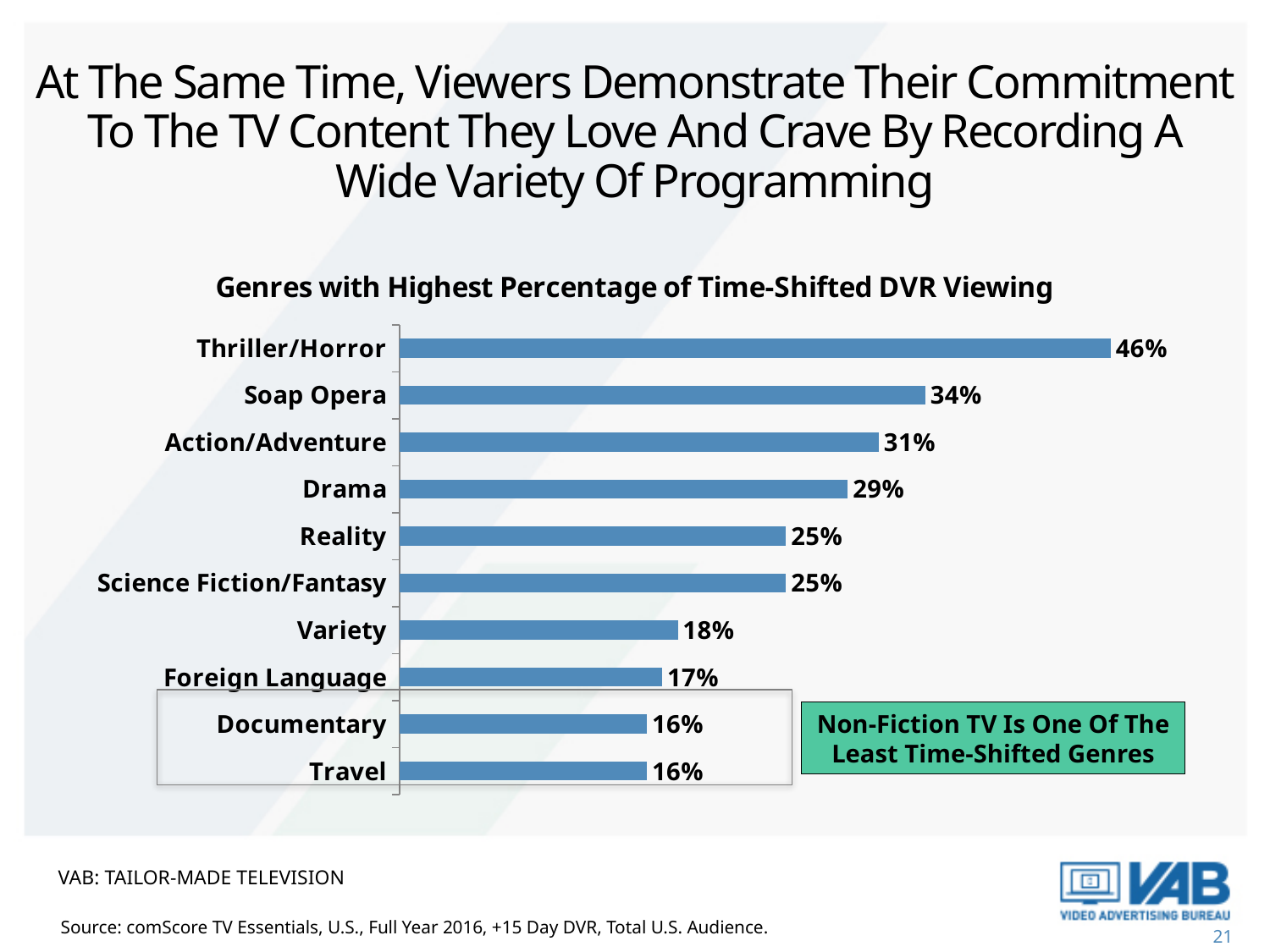
What does the green callout box on the chart say? Non-Fiction TV Is One Of The Least Time-Shifted Genres What is the title of the chart? Genres with Highest Percentage of Time-Shifted DVR Viewing Which is larger, the value for Soap Opera or the value for Reality? Soap Opera How many genres are shown in the chart? 10 What is the value for Foreign Language? 17% What kind of chart is shown on the slide? Bar chart What is the difference between the values for Action/Adventure and Variety? 13% Which genre has the highest percentage of time-shifted DVR viewing? Thriller/Horror What is the value for Drama? 29% What is the value for Thriller/Horror? 46% What is the difference between the values for Thriller/Horror and Soap Opera? 12% What is the value for Science Fiction/Fantasy? 25%